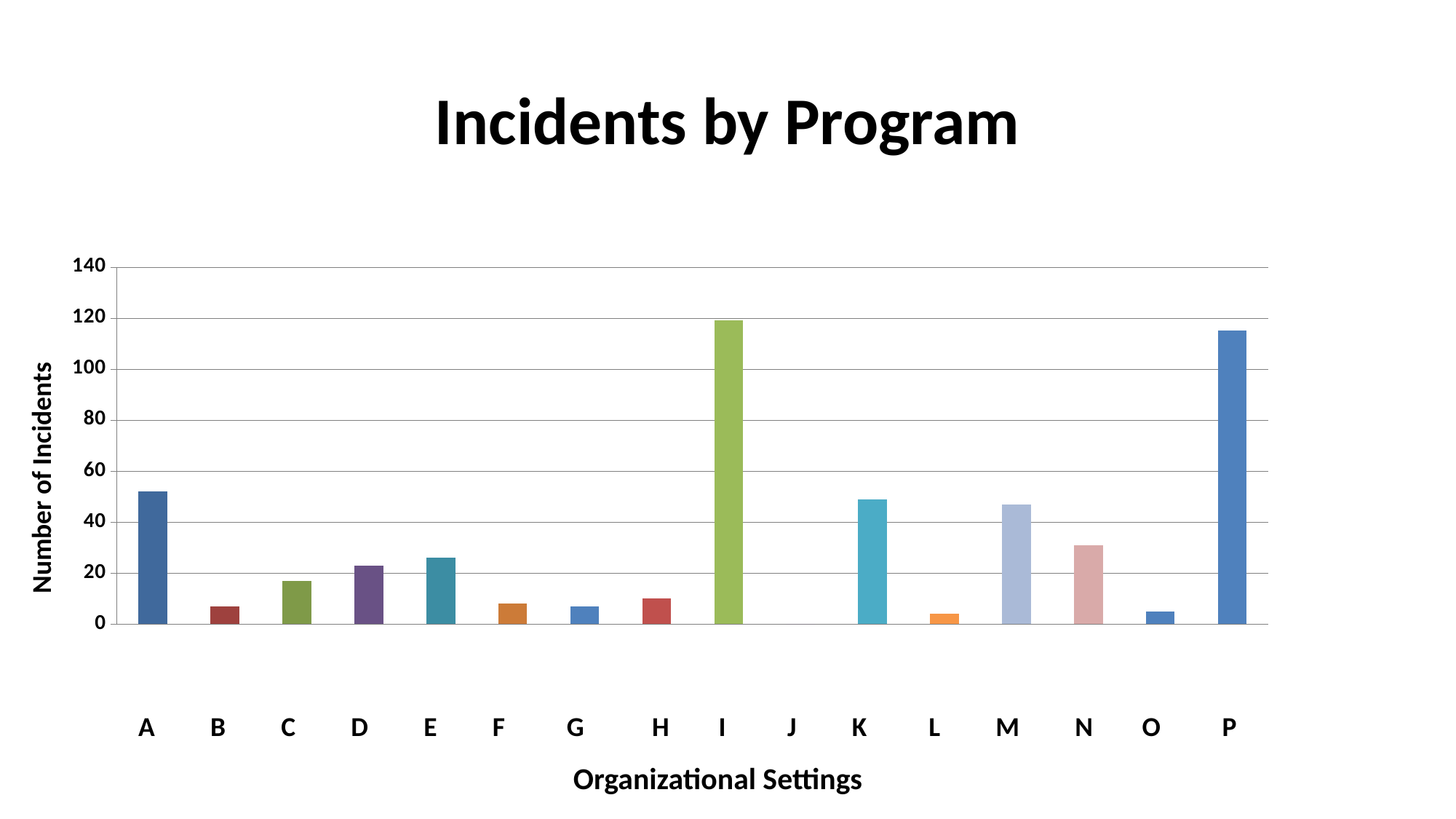
Is the value for B greater or less than 20? less Is the value for I greater or less than 100? greater Which has more incidents, A or B? A What is the title of the chart? Incidents by Program Which has more incidents, N or E? N Is the value for P greater or less than 100? greater What kind of chart is shown on the slide? bar chart Which has more incidents, I or K? I How many categories are shown on the x axis? 16